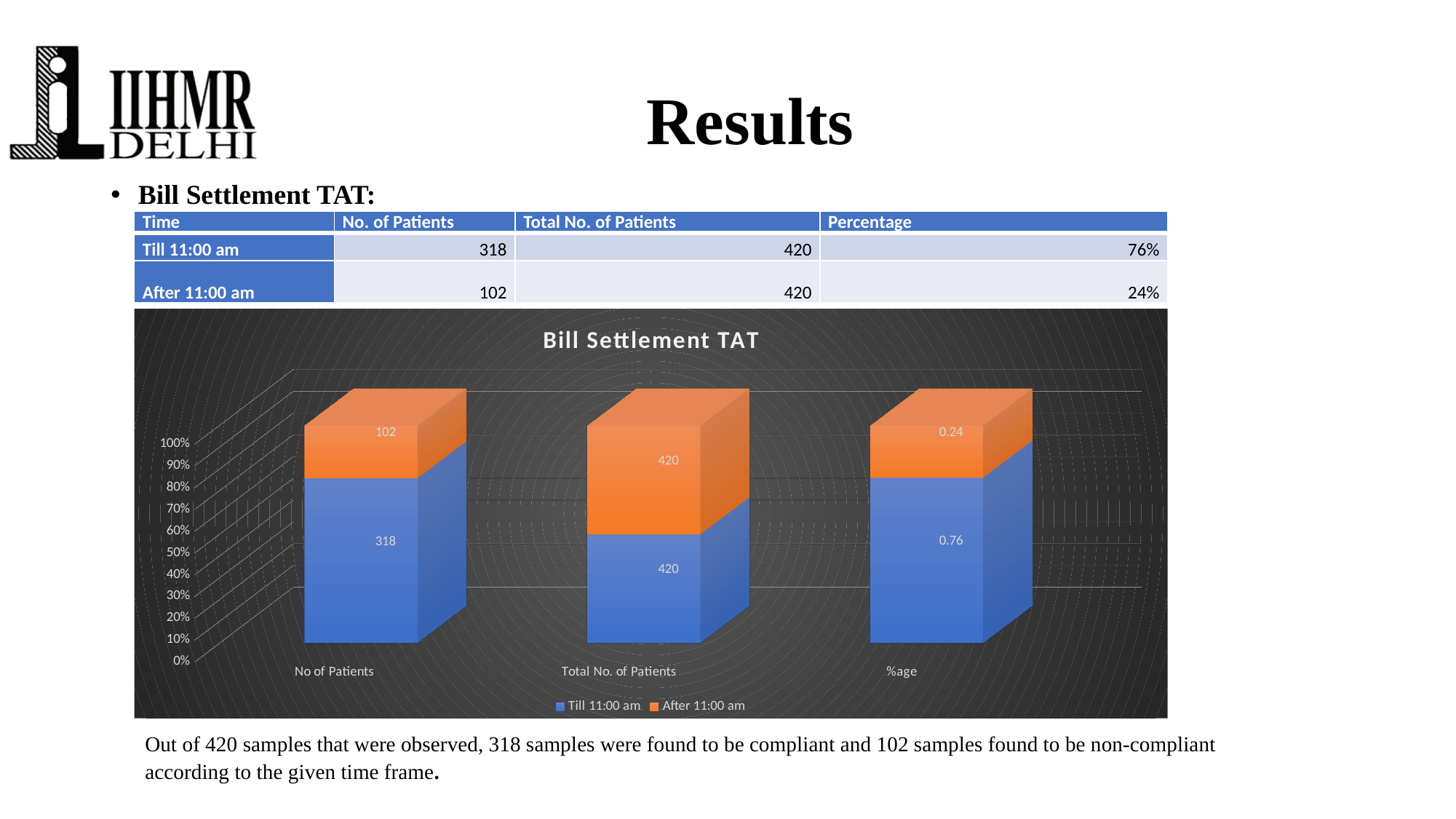
What is the value of the After 11:00 am series for No of Patients? 102 What kind of chart is shown on the slide? Stacked bar chart How many categories are shown on the x axis of the chart? 3 What is the value of the Till 11:00 am series for %age? 0.76 What is the title of the chart? Bill Settlement TAT What is the value of the After 11:00 am series for Total No. of Patients? 420 Which series has the larger value for No of Patients, Till 11:00 am or After 11:00 am? Till 11:00 am Which colour represents the After 11:00 am series in the chart? Orange What is the value of the Till 11:00 am series for No of Patients? 318 How many series does the chart legend list? 2 What is the difference between the Till 11:00 am and After 11:00 am values for No of Patients? 216 What is the total of the two stacked values for No of Patients? 420